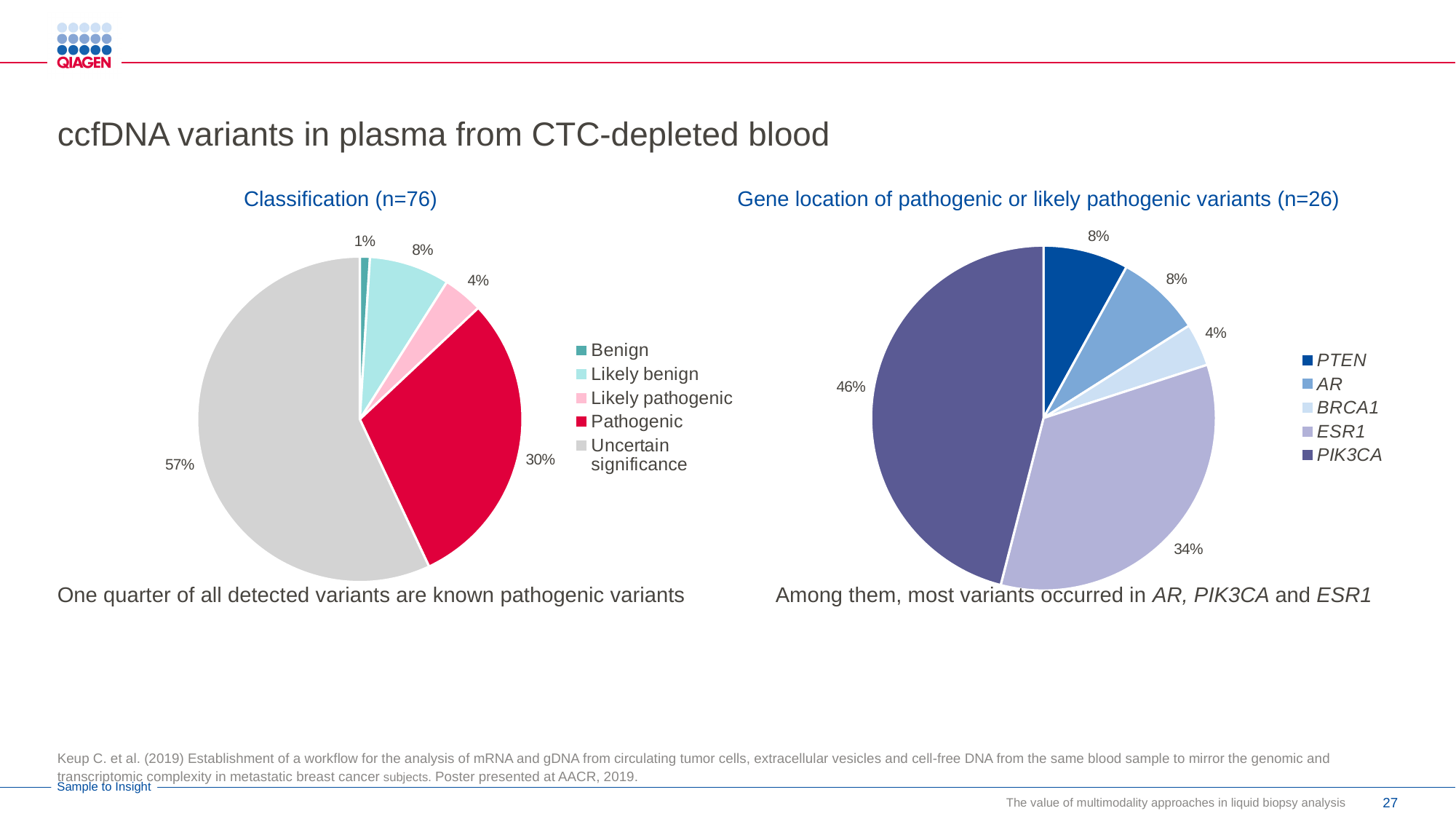
In the Gene location of pathogenic or likely pathogenic variants (n=26) chart, which gene has the largest share? PIK3CA In the Classification (n=76) chart, what is the difference in percentage points between Uncertain significance and Pathogenic? 27 In the Gene location of pathogenic or likely pathogenic variants (n=26) chart, what share of variants is in BRCA1? 4% In the Classification (n=76) chart, which category has the largest share? Uncertain significance In the Gene location of pathogenic or likely pathogenic variants (n=26) chart, which is larger, the share for ESR1 or the share for PTEN? ESR1 In the Classification (n=76) chart, what share of variants is of Uncertain significance? 57% In the Classification (n=76) chart, what share of variants is Pathogenic? 30% In the Classification (n=76) chart, which category has the smallest share? Benign What type of chart is the Classification (n=76) chart? Pie chart In the Classification (n=76) chart, how many categories does the legend list? 5 In the Gene location of pathogenic or likely pathogenic variants (n=26) chart, what share of variants is in PIK3CA? 46% In the Gene location of pathogenic or likely pathogenic variants (n=26) chart, what is the difference in percentage points between PIK3CA and ESR1? 12